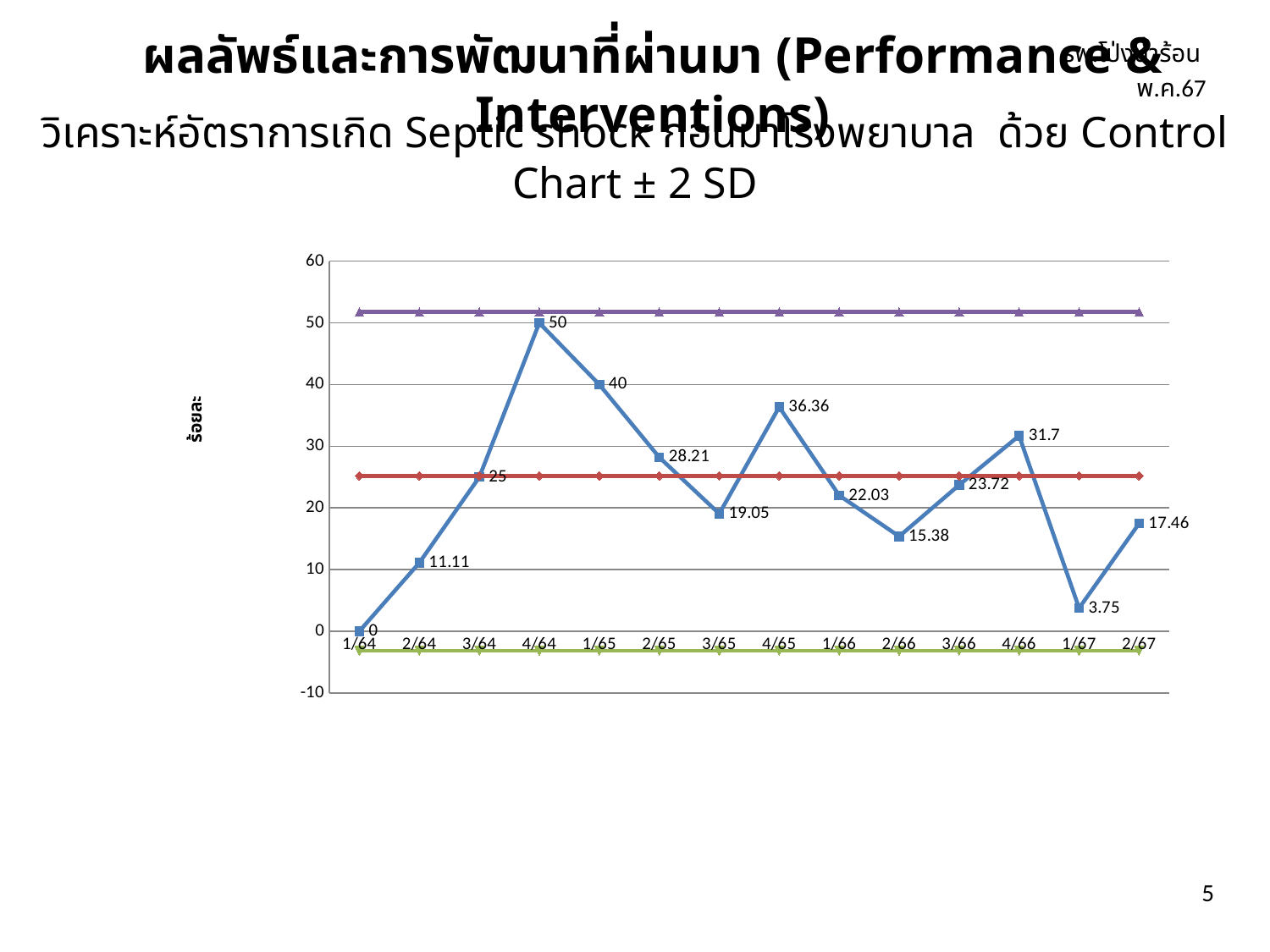
What is the value for 2/67? 17.46 What is the value for 4/65? 36.36 Which period has the lowest value on the data line? 1/64 What kind of chart is shown on the slide? line chart What is the difference between the values for 4/64 and 1/65? 10 What is the difference between the values for 4/66 and 1/67? 27.95 Which is larger, the value for 3/65 or the value for 1/66? 1/66 Which period has the highest value on the data line? 4/64 What is the value for 4/64? 50 What is the label on the y axis? ร้อยละ How many periods are shown on the x axis? 14 Is the value for 2/66 greater or less than 20? less